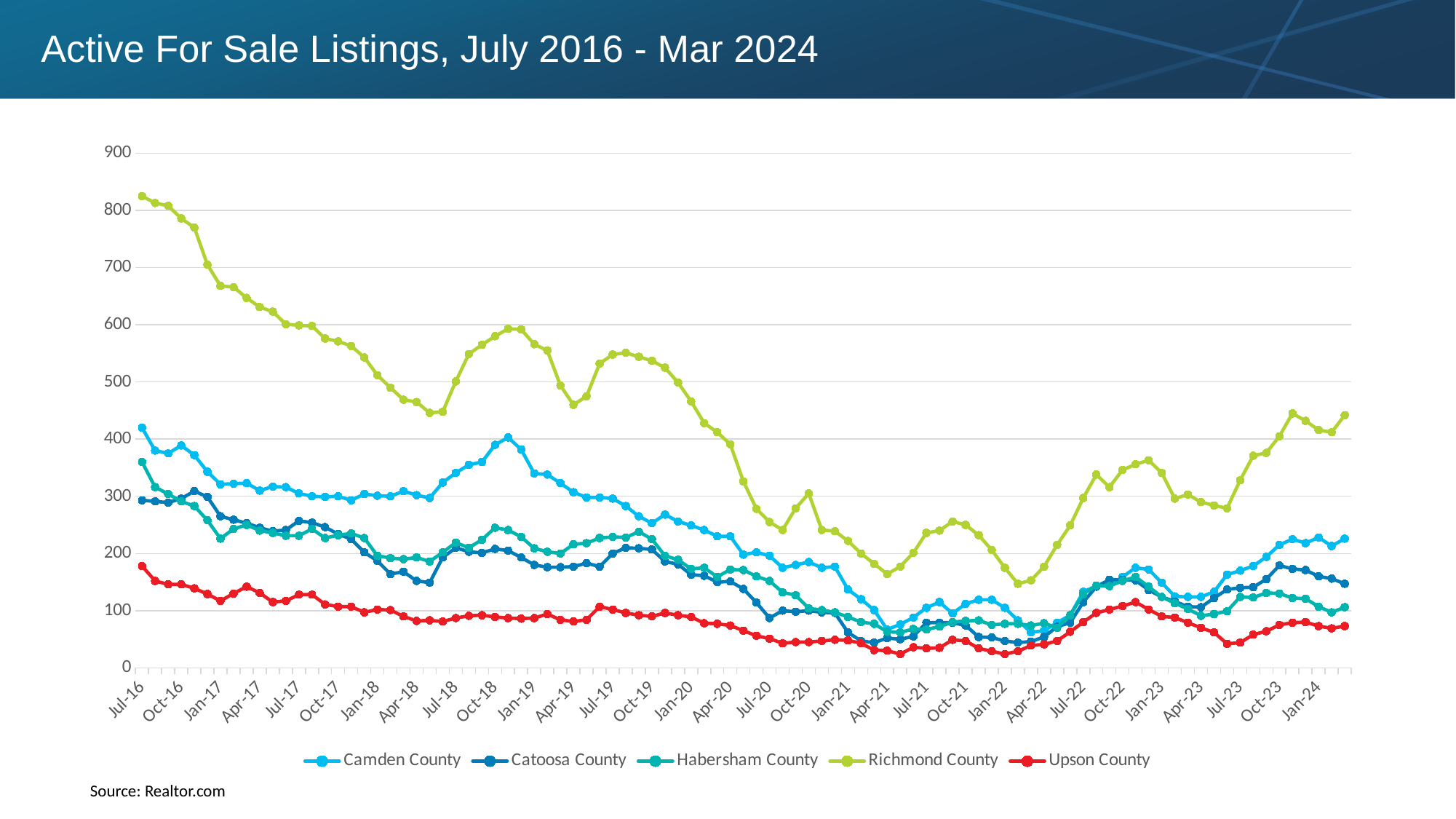
Which county has the highest number of active listings at Jul-16? Richmond County Does the Richmond County line rise or fall overall from Jul-16 to Apr-21? fall What is the title of the chart? Active For Sale Listings, July 2016 - Mar 2024 Which county has the lowest number of active listings at Jul-16? Upson County Is the value for Upson County at Jul-16 greater or less than 200? less How many series does the legend list? 5 Is the value for Richmond County at Jul-16 greater or less than 800? greater Which county has the highest number of active listings at the last point on the chart (Mar-24)? Richmond County What kind of chart is shown on the slide? line chart Which is larger at Jul-16, Camden County or Catoosa County? Camden County What source is cited for the chart data? Realtor.com